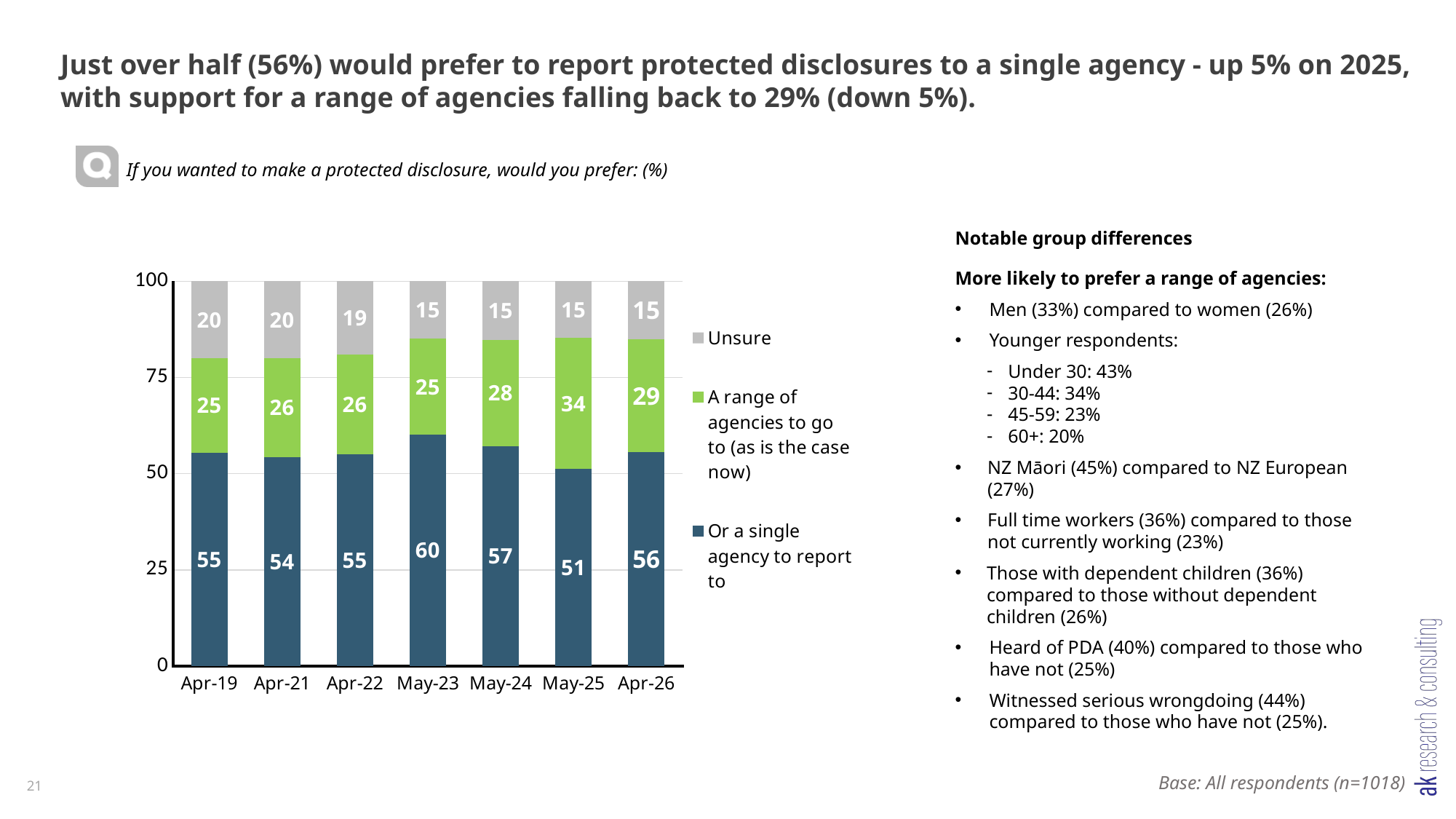
What is the value for 'A range of agencies to go to (as is the case now)' in May-25? 34 What is the difference between the 'A range of agencies to go to' values for May-25 and Apr-26? 5 Which is larger: the 'Unsure' value in Apr-19 or in May-24? Apr-19 In which period is the value for 'Or a single agency to report to' lowest? May-25 How many time periods are shown on the x axis? 7 What kind of chart is shown on the slide? Stacked bar chart Which colour represents 'Unsure' in the chart? Grey What is the value for 'Or a single agency to report to' in Apr-26? 56 In which period is the value for 'Or a single agency to report to' highest? May-23 What is the value for 'Unsure' in Apr-22? 19 How many series does the legend list? 3 What is the total of the stacked bar for Apr-21? 100